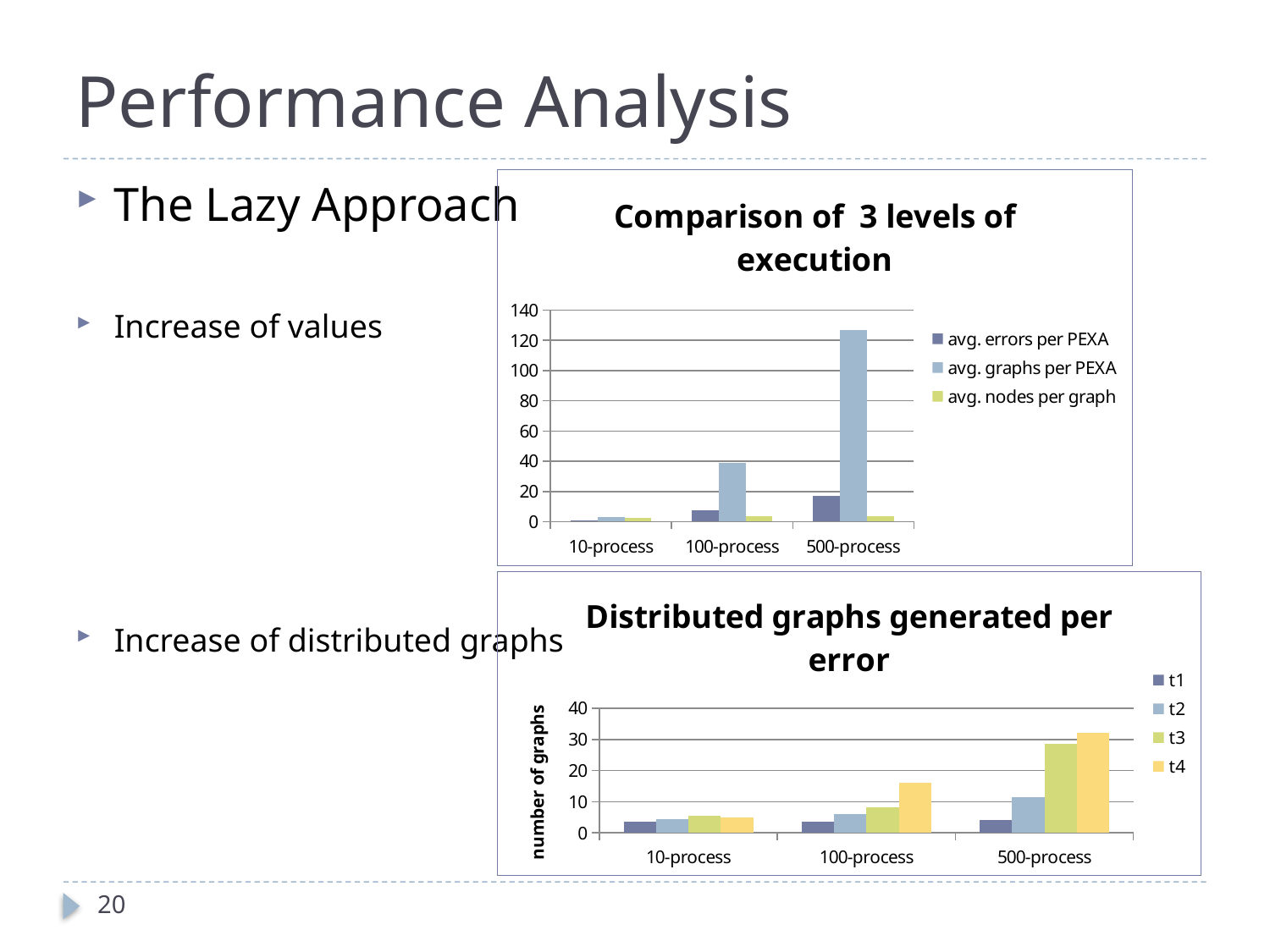
In the 'Comparison of 3 levels of execution' chart, which is larger at 500-process: avg. graphs per PEXA or avg. nodes per graph? avg. graphs per PEXA In the 'Distributed graphs generated per error' chart, is the value of t4 for 500-process greater or less than 30? greater In the 'Distributed graphs generated per error' chart, how many categories are shown on the x axis? 3 What is the y-axis label of the 'Distributed graphs generated per error' chart? number of graphs In the 'Comparison of 3 levels of execution' chart, is the value of avg. graphs per PEXA for 100-process greater or less than 60? less What kind of chart is 'Distributed graphs generated per error'? bar chart In the 'Comparison of 3 levels of execution' chart, which category has the highest value for avg. graphs per PEXA? 500-process In the 'Comparison of 3 levels of execution' chart, is the value of avg. graphs per PEXA for 500-process greater or less than 100? greater In the 'Comparison of 3 levels of execution' chart, does avg. errors per PEXA rise or fall from 10-process to 500-process? rise In the 'Distributed graphs generated per error' chart, how many series does the legend list? 4 In the 'Distributed graphs generated per error' chart, which series has the lowest value at 500-process? t1 In the 'Comparison of 3 levels of execution' chart, how many series does the legend list? 3